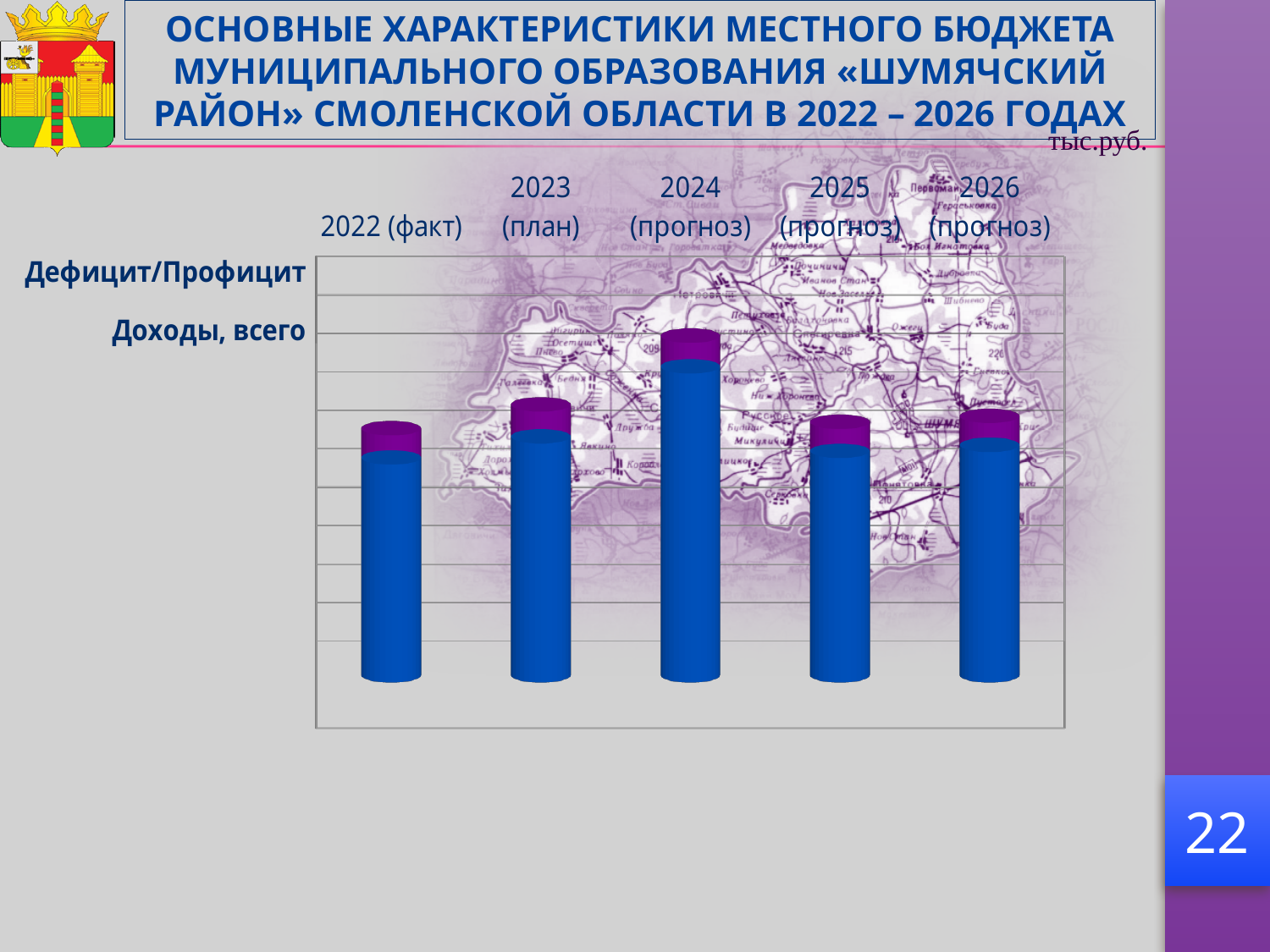
What kind of chart is shown on the slide? bar chart How many year categories are plotted along the x axis of the chart? 5 Which bar is taller, 2023 (план) or 2022 (факт)? 2023 (план) Which bar is taller, 2024 (прогноз) or 2025 (прогноз)? 2024 (прогноз) What unit of measurement is indicated for the chart? тыс.руб. Which bar is taller, 2024 (прогноз) or 2022 (факт)? 2024 (прогноз) Which year has the tallest bar in the chart? 2024 (прогноз) Do the bar heights rise or fall from 2024 (прогноз) to 2025 (прогноз)? fall Do the bar heights rise or fall from 2022 (факт) to 2024 (прогноз)? rise